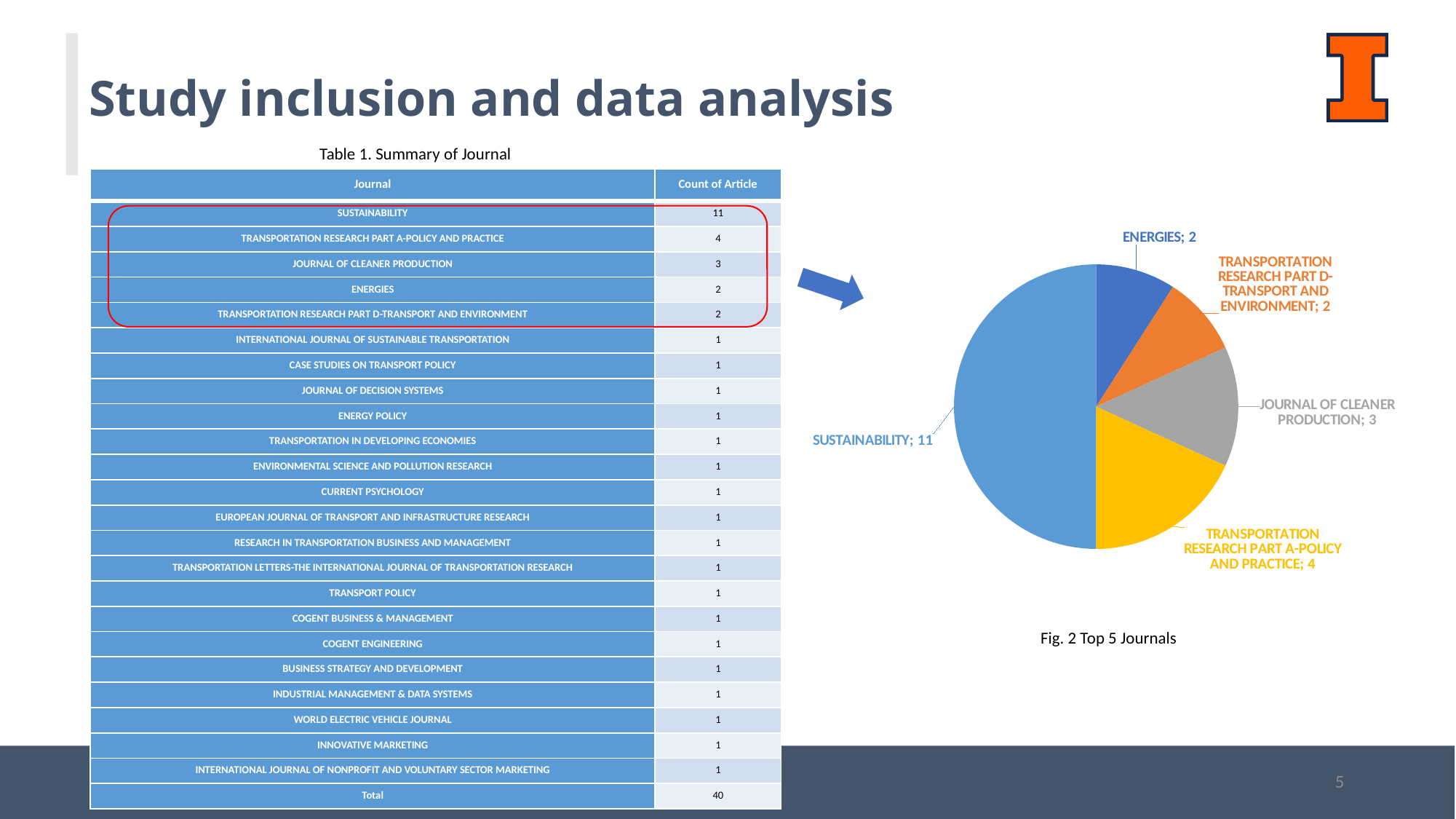
In the pie chart, how many articles are attributed to SUSTAINABILITY? 11 What share of the pie chart does SUSTAINABILITY represent? 50% What kind of chart is shown in Fig. 2 Top 5 Journals? pie chart In the pie chart, what is the difference between the values for SUSTAINABILITY and TRANSPORTATION RESEARCH PART A-POLICY AND PRACTICE? 7 In the pie chart, what is the value for ENERGIES? 2 In the pie chart, which is larger: JOURNAL OF CLEANER PRODUCTION or TRANSPORTATION RESEARCH PART A-POLICY AND PRACTICE? TRANSPORTATION RESEARCH PART A-POLICY AND PRACTICE In the pie chart, what is the value for JOURNAL OF CLEANER PRODUCTION? 3 In the pie chart, what is the value for TRANSPORTATION RESEARCH PART A-POLICY AND PRACTICE? 4 What is the caption of the pie chart on the slide? Fig. 2 Top 5 Journals How many slices does the pie chart have? 5 What is the total of all values shown in the pie chart? 22 Which journal has the largest slice in the pie chart? SUSTAINABILITY